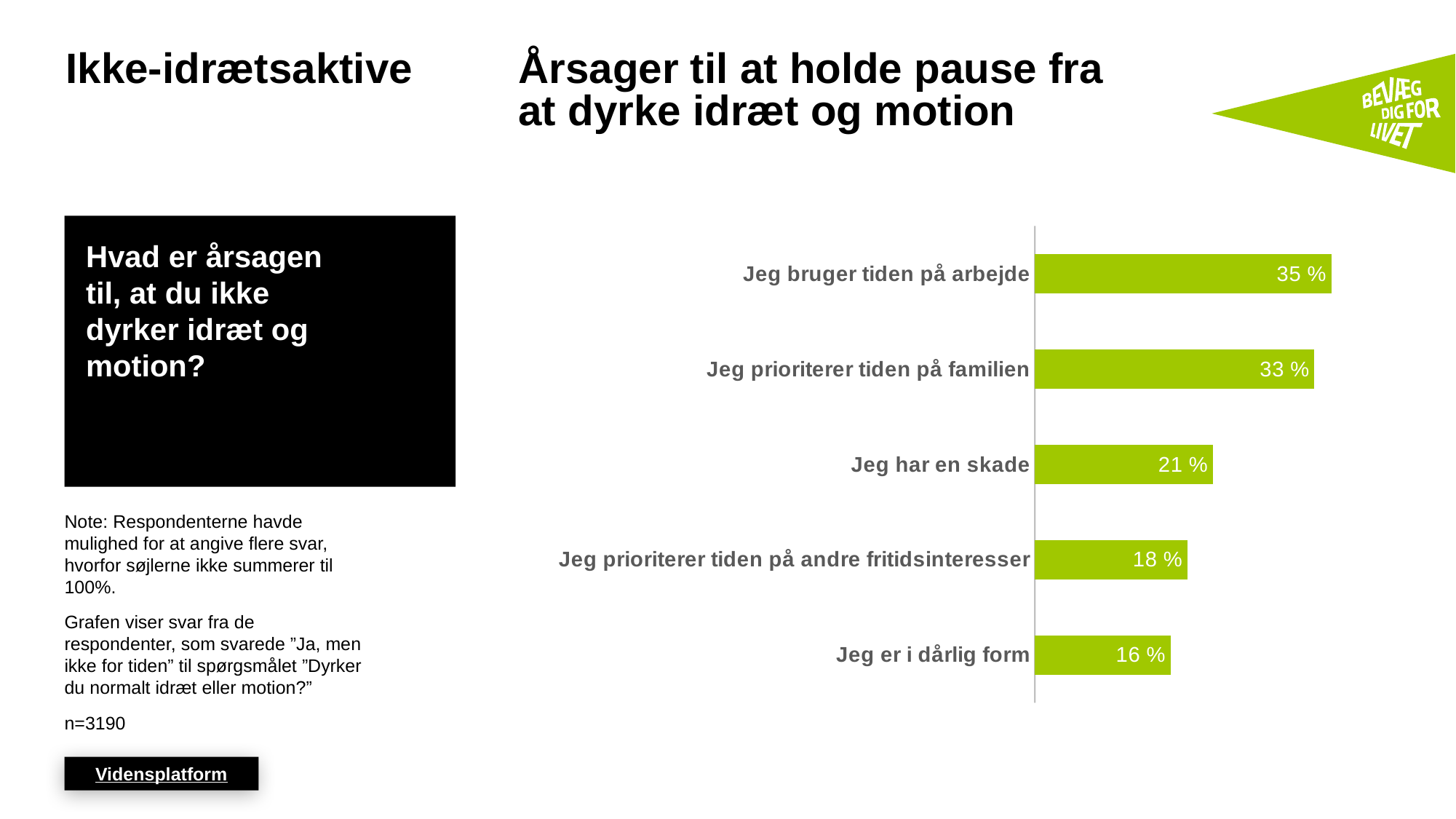
Which category has the highest value? Jeg bruger tiden på arbejde What is the difference between "Jeg har en skade" and "Jeg er i dårlig form"? 5 % What is the value for "Jeg bruger tiden på arbejde"? 35 % What kind of chart is shown on the slide? Bar chart What is the value for "Jeg har en skade"? 21 % What colour are the bars in the chart? Green How many categories are shown in the chart? 5 What is the value for "Jeg prioriterer tiden på andre fritidsinteresser"? 18 % What is the value for "Jeg er i dårlig form"? 16 % What is the difference between "Jeg bruger tiden på arbejde" and "Jeg prioriterer tiden på familien"? 2 % Which is larger: "Jeg prioriterer tiden på familien" or "Jeg har en skade"? Jeg prioriterer tiden på familien Which category has the lowest value? Jeg er i dårlig form